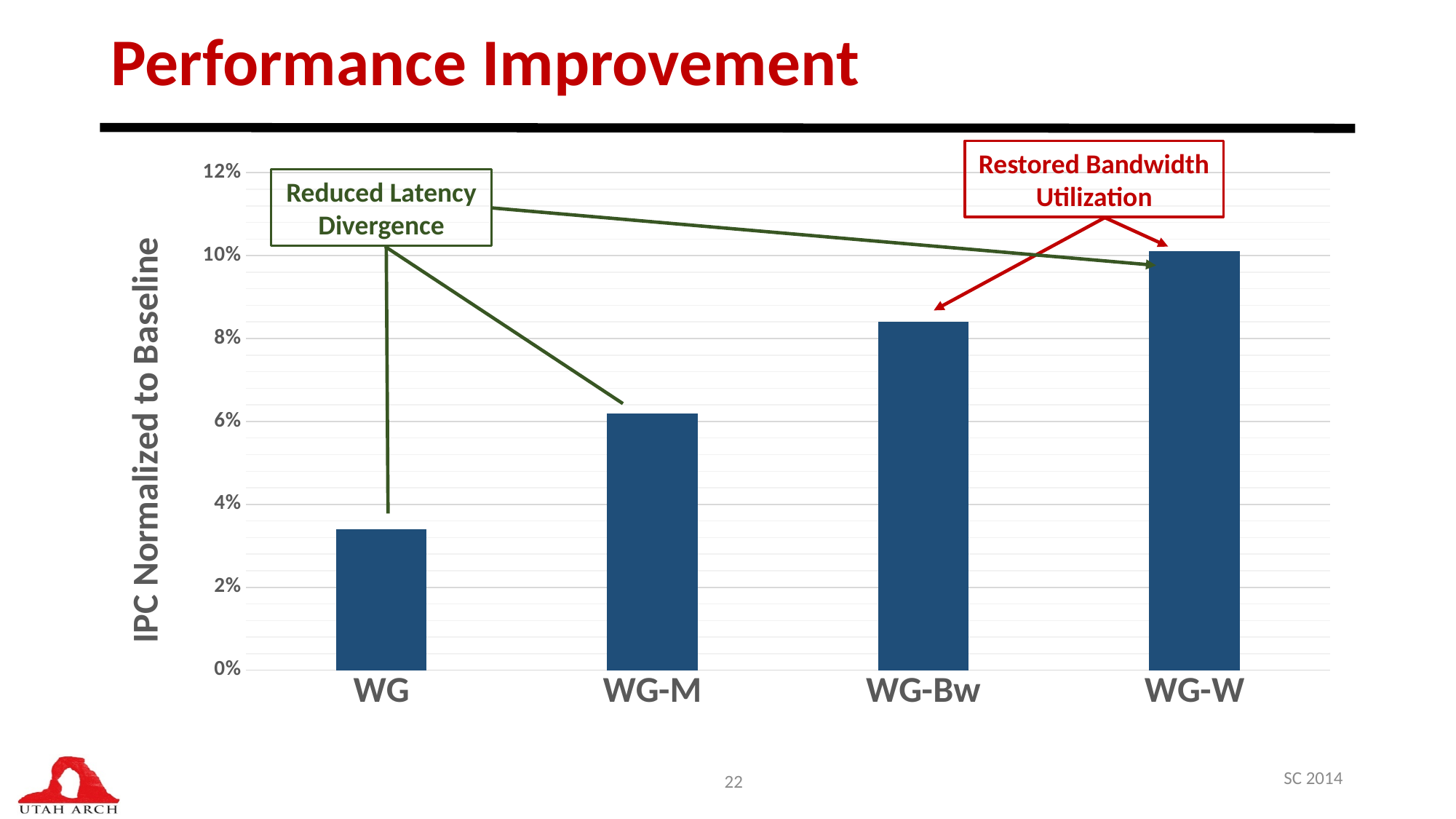
Which is larger, the value for WG-Bw or the value for WG-M? WG-Bw How many categories are plotted on the x axis? 4 What kind of chart is shown on the slide? bar chart Which is larger, the value for WG or the value for WG-W? WG-W Which category has the lowest IPC normalized to baseline? WG Is the value for WG-Bw greater or less than 8%? greater Is the value for WG-M greater or less than 8%? less Is the value for WG greater or less than 4%? less What is the label on the y axis of the chart? IPC Normalized to Baseline Do the values rise or fall moving from WG to WG-W along the x axis? rise Which category has the highest IPC normalized to baseline? WG-W